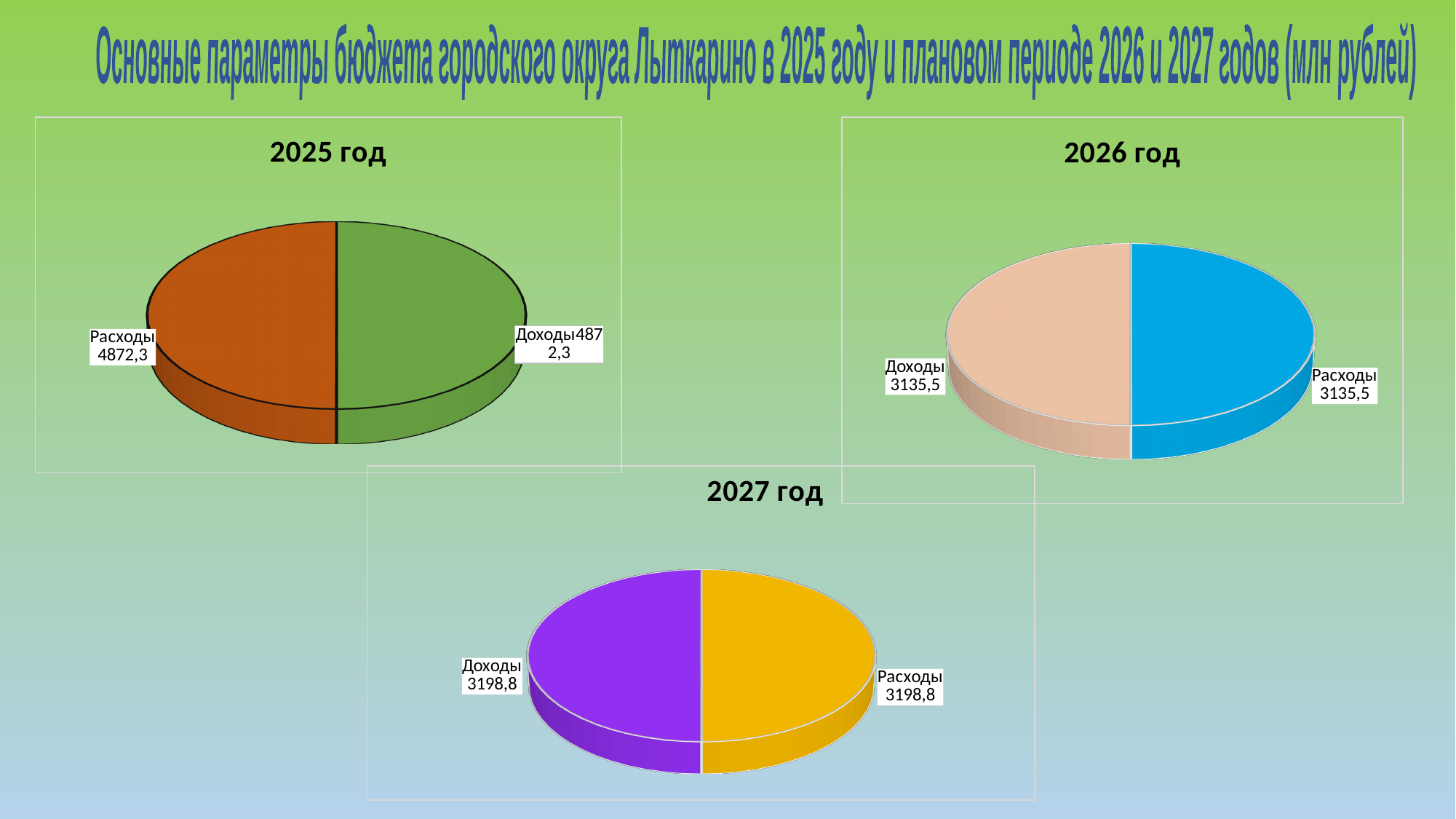
In the 2026 год chart, what share of the pie does Доходы take? 50% How many pie charts are shown on the slide? 3 In the 2027 год chart, what colour is the Доходы slice? Purple In the 2026 год chart, what is the value for Расходы? 3135,5 In the 2026 год chart, what is the value for Доходы? 3135,5 In the 2025 год chart, what is the value for Доходы? 4872,3 In the 2025 год chart, what is the value for Расходы? 4872,3 What kind of chart is the 2025 год chart? Pie chart In the 2027 год chart, what is the value for Доходы? 3198,8 How many slices does the 2026 год chart have? 2 In the 2027 год chart, what is the difference between Доходы and Расходы? 0 In the 2027 год chart, what is the value for Расходы? 3198,8